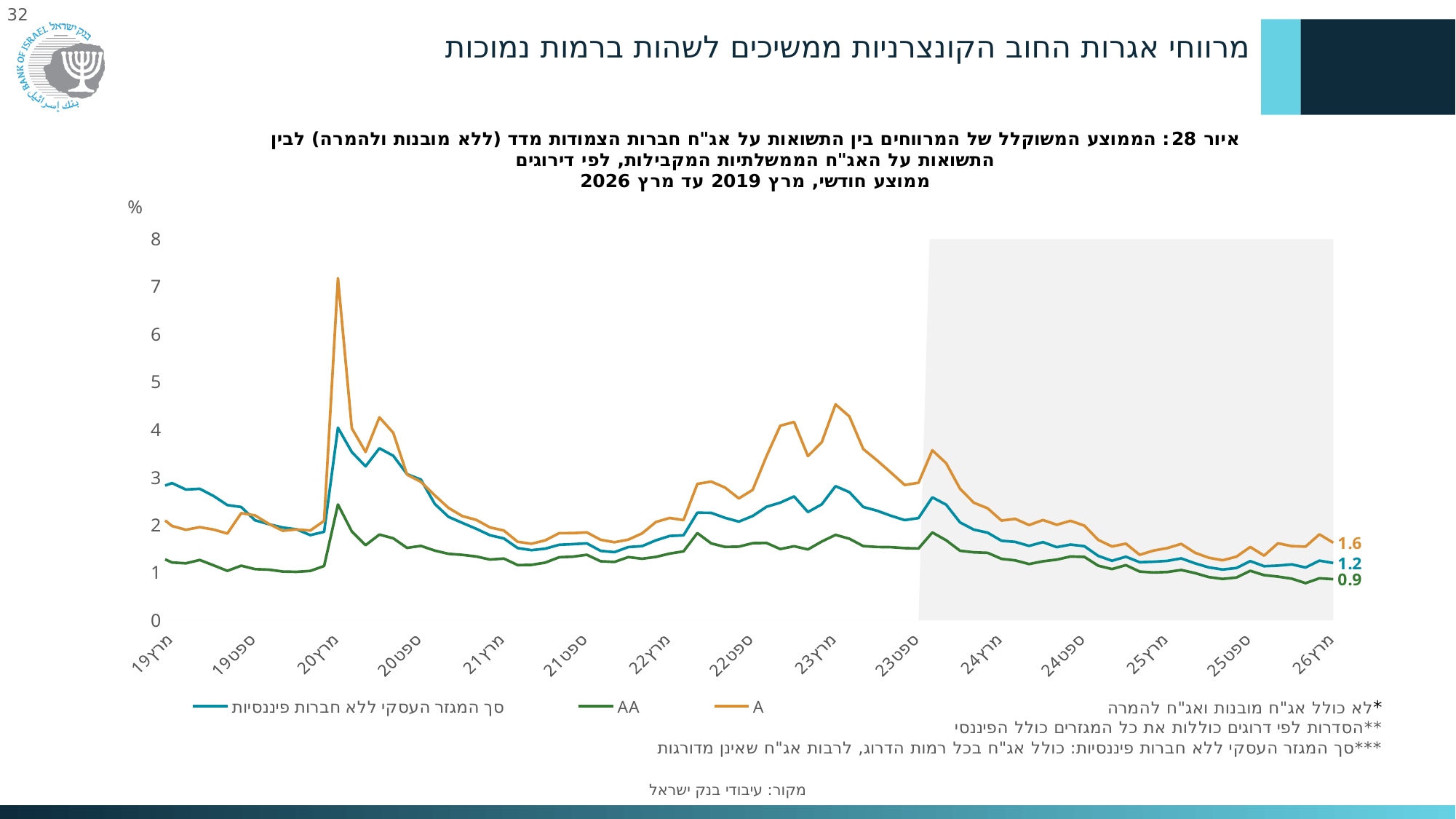
Is the value of the AA series at מרץ19 greater or less than 2? less Which series is drawn in orange? A Is the peak of the A series around מרץ20 greater or less than 6? greater What type of chart is shown on the slide? line chart What is the final value shown for the series סך המגזר העסקי ללא חברות פיננסיות at the end of the chart? 1.2 What unit is shown on the y axis? % What is the difference between the final values of the A series and the AA series? 0.7 What is the final value shown for the AA series at the end of the chart? 0.9 Which series has the lowest value at the end of the chart? AA Which series has the highest value at the end of the chart? A How many series does the legend list? 3 What is the final value shown for the A series at the end of the chart? 1.6